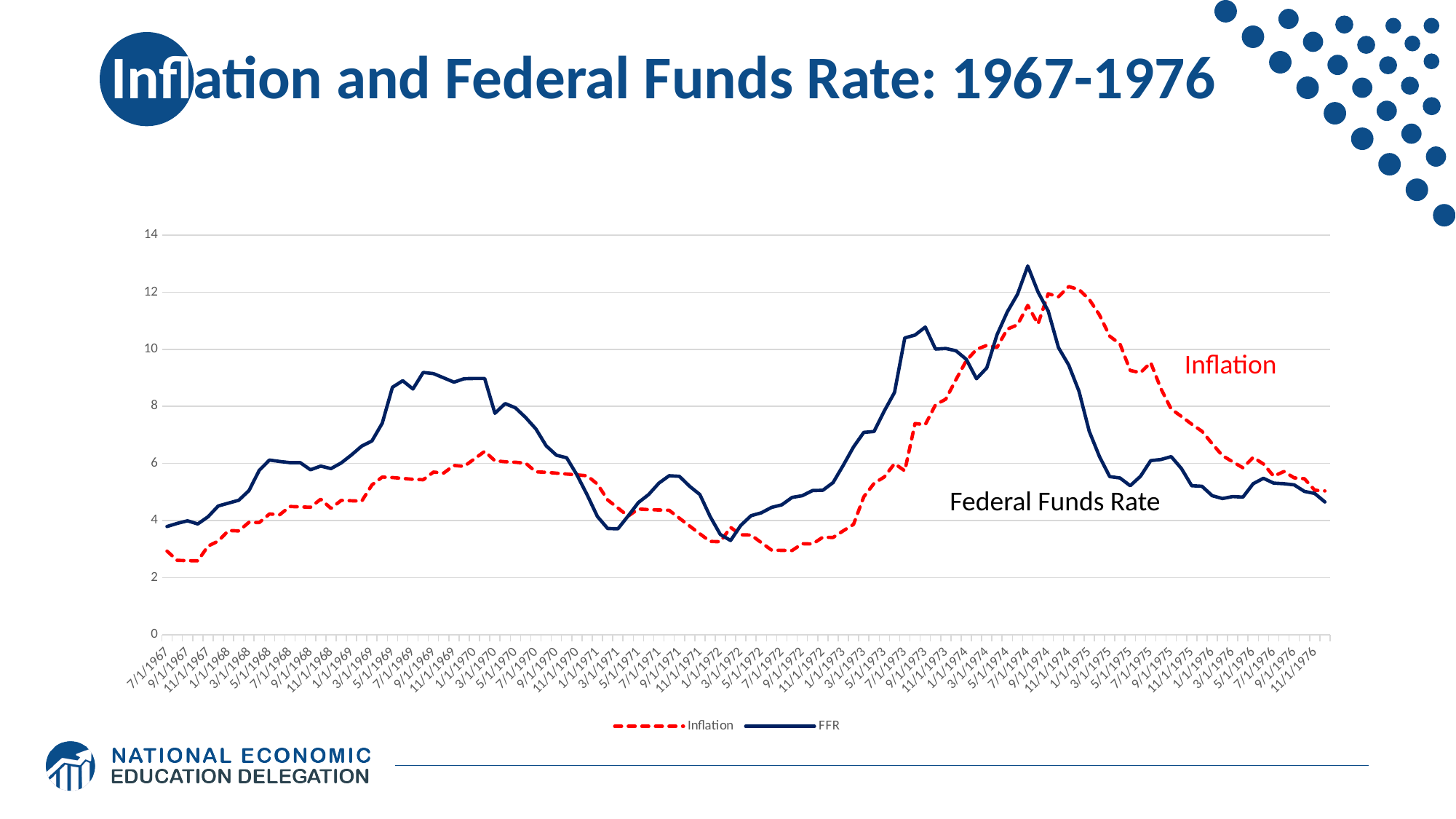
Is the FFR value at 7/1/1974 greater or less than 12? greater What is the title of the chart? Inflation and Federal Funds Rate: 1967-1976 At 7/1/1969, which series has the larger value, Inflation or FFR? FFR What are the two series named in the legend? Inflation and FFR At 1/1/1975, which series has the larger value, Inflation or FFR? Inflation Is the FFR value at 9/1/1969 greater or less than 8? greater What kind of chart is shown on the slide? Line chart Which series reaches the higher peak value over the whole period? FFR Does the FFR series rise or fall between 7/1/1974 and 3/1/1975? Fall Is the Inflation value at 7/1/1972 greater or less than 4? less How many series does the legend list? 2